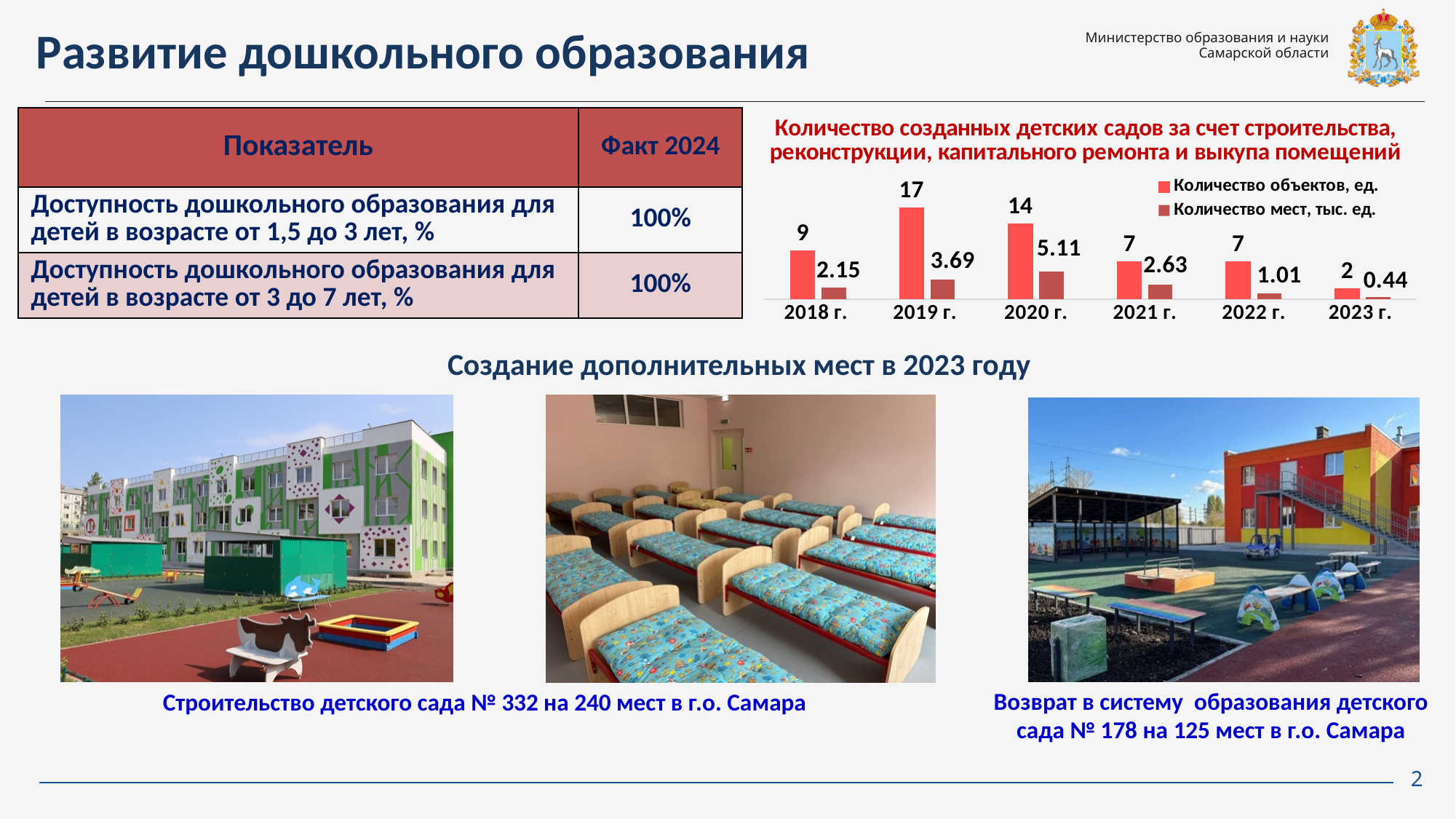
What is the value of "Количество мест, тыс. ед." for 2023 г.? 0.44 Which year has a larger value of "Количество мест, тыс. ед.": 2018 г. or 2021 г.? 2021 г. What is the value of "Количество мест, тыс. ед." for 2020 г.? 5.11 How many years are shown on the x axis of the chart? 6 What type of chart is shown on the slide? bar chart In which year is "Количество объектов, ед." the highest? 2019 г. What is the title of the chart? Количество созданных детских садов за счет строительства, реконструкции, капитального ремонта и выкупа помещений What is the value of "Количество объектов, ед." for 2019 г.? 17 How many series does the chart legend list? 2 In which year is "Количество мест, тыс. ед." the lowest? 2023 г. Does "Количество объектов, ед." rise or fall from 2020 г. to 2023 г.? fall What is the difference in "Количество объектов, ед." between 2019 г. and 2020 г.? 3